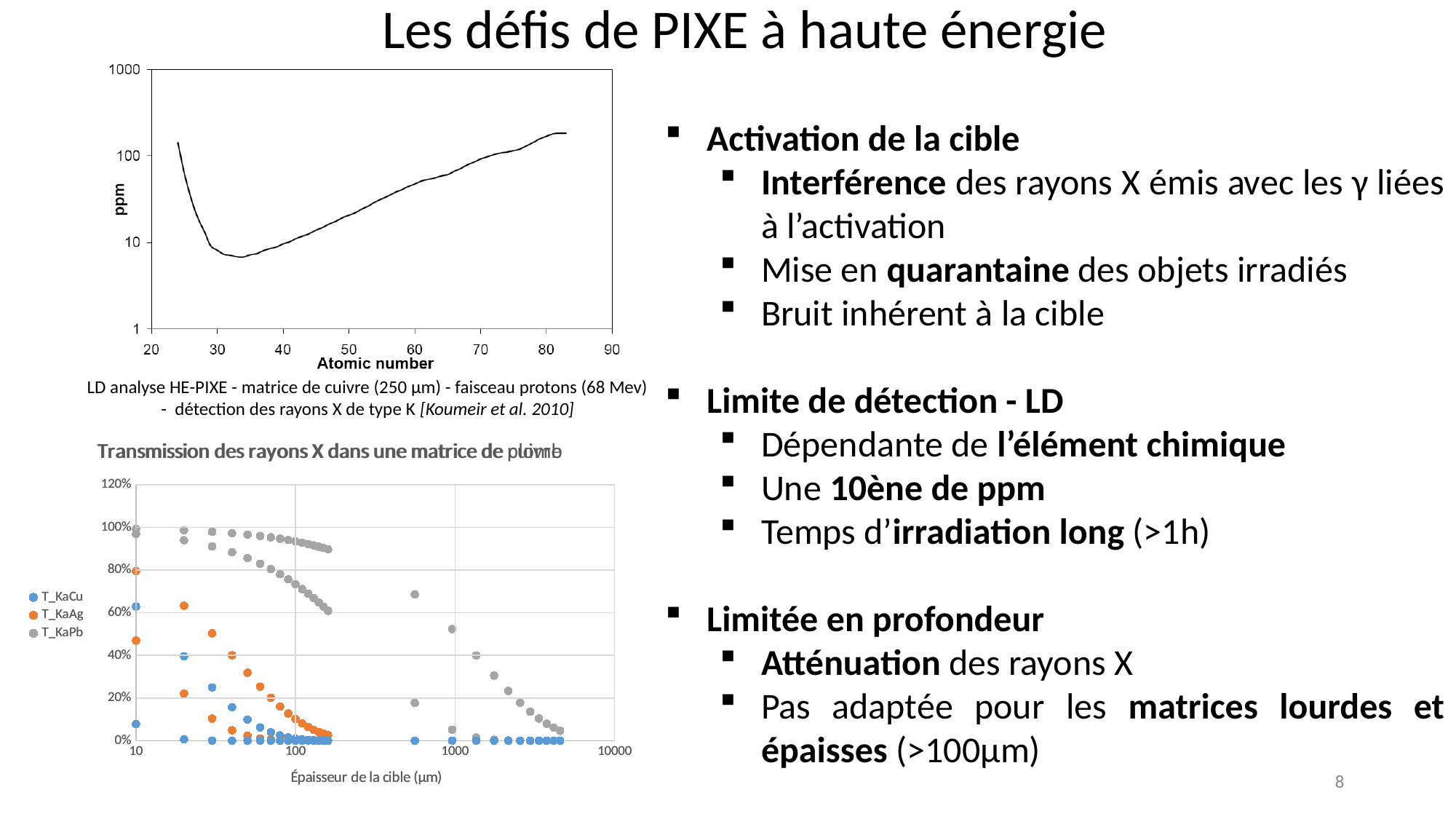
What are the legend entries of the bottom chart? T_KaCu, T_KaAg, T_KaPb In the top chart, is the value at atomic number 50 greater or less than 100 ppm? less What is the x-axis label of the top chart? Atomic number In the bottom chart, is the T_KaPb value at 10 µm greater or less than 80%? greater In the top chart, is the value at atomic number 80 greater or less than 100 ppm? greater How many series does the legend of the bottom chart list? 3 What kind of chart is the top chart (ppm versus Atomic number)? line chart In the top chart, does the curve rise or fall between atomic number 40 and atomic number 80? rise What kind of chart is the bottom chart (Transmission des rayons X)? scatter chart In the bottom chart, do the transmission values rise or fall as the target thickness increases? fall In the bottom chart, which series has the highest transmission at a thickness of 100 µm? T_KaPb